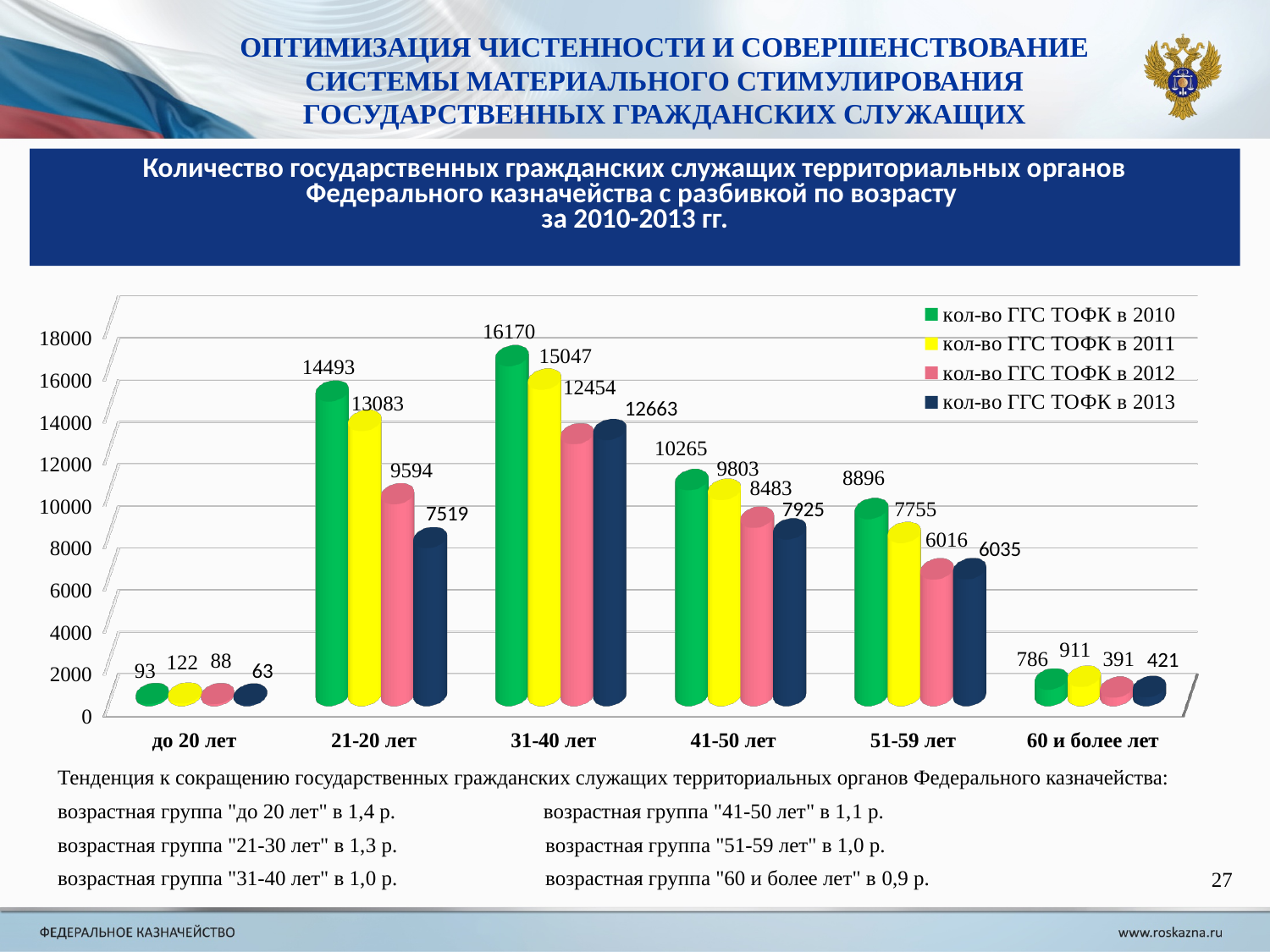
Which age category has the highest value for "кол-во ГГС ТОФК в 2012"? 31-40 лет How many age categories are shown on the x axis? 6 What is the value for "кол-во ГГС ТОФК в 2013" in the "21-20 лет" category? 7519 What is the value for "кол-во ГГС ТОФК в 2010" in the "31-40 лет" category? 16170 What is the value for "кол-во ГГС ТОФК в 2011" in the "60 и более лет" category? 911 What colour are the bars for "кол-во ГГС ТОФК в 2011"? Yellow What type of chart is shown on the slide? Bar chart How many series does the legend list? 4 Do the values for the "21-20 лет" category rise or fall from 2010 to 2013? Fall Which age category has the lowest value for "кол-во ГГС ТОФК в 2013"? до 20 лет Which is larger in the "51-59 лет" category: the value for 2012 or the value for 2013? 2013 What is the difference between the 2010 and 2013 values in the "41-50 лет" category? 2340